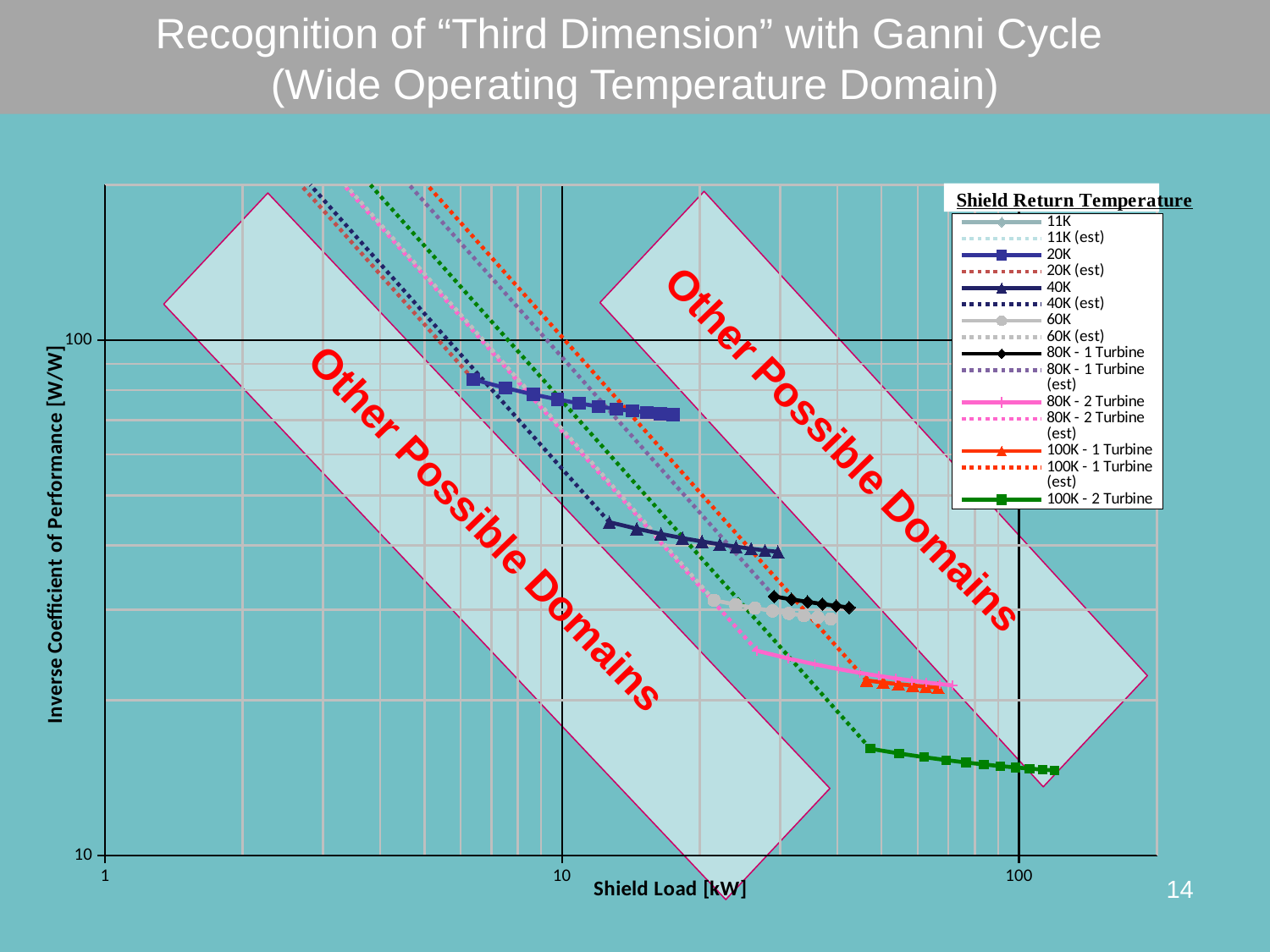
Do the values of the 100K - 2 Turbine series rise or fall as Shield Load increases? fall Which plotted series has the lowest Inverse Coefficient of Performance values? 100K - 2 Turbine Are the Inverse Coefficient of Performance values for the 20K series greater or less than 100? less What is the label of the x axis? Shield Load [kW] How many series does the legend list? 15 Are the Shield Load values for the 40K series greater or less than 10 kW? greater Are the Inverse Coefficient of Performance values for the 100K - 2 Turbine series greater or less than 10? greater What kind of chart is shown on the slide? line chart Which series has higher Inverse Coefficient of Performance values, 40K or 80K - 1 Turbine? 40K Which series has higher Inverse Coefficient of Performance values, 20K or 100K - 2 Turbine? 20K What is the title of the legend? Shield Return Temperature